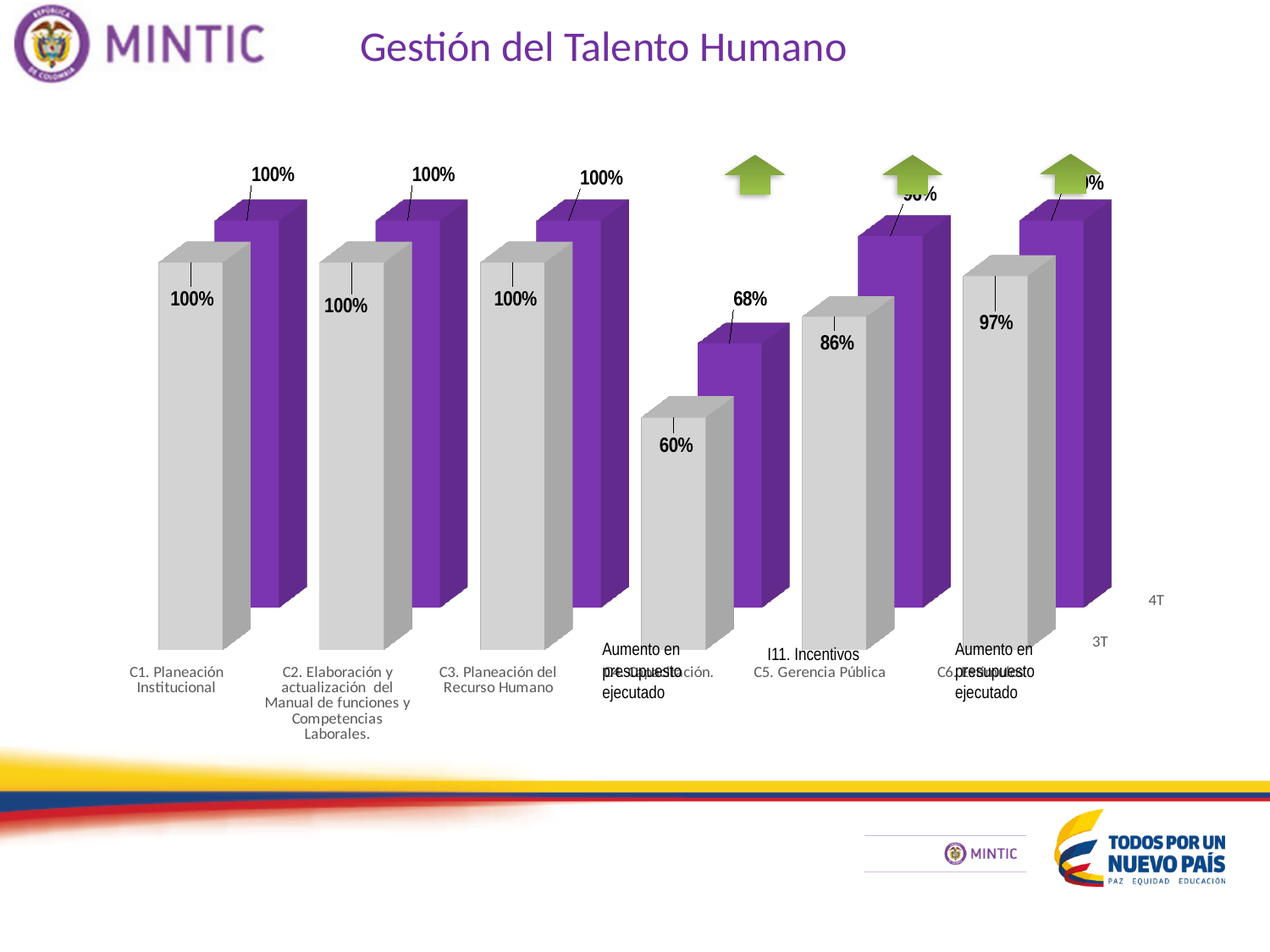
What is the 3T value for the fourth category from the left? 60% How many series does the chart show? 2 What is the 4T value for the fourth category from the left? 68% What is the 3T value for C5. Gerencia Pública? 86% What is the lowest 3T value shown on the chart? 60% Which has the larger 3T value: C5. Gerencia Pública or the fourth category from the left? C5. Gerencia Pública What is the 3T value for C3. Planeación del Recurso Humano? 100% For the fourth category from the left, what is the difference between the 4T value and the 3T value? 8 percentage points How many categories are plotted on the chart? 6 What is the 3T value for the rightmost category? 97% What kind of chart is shown on the slide? Bar chart What is the 3T value for C1. Planeación Institucional? 100%